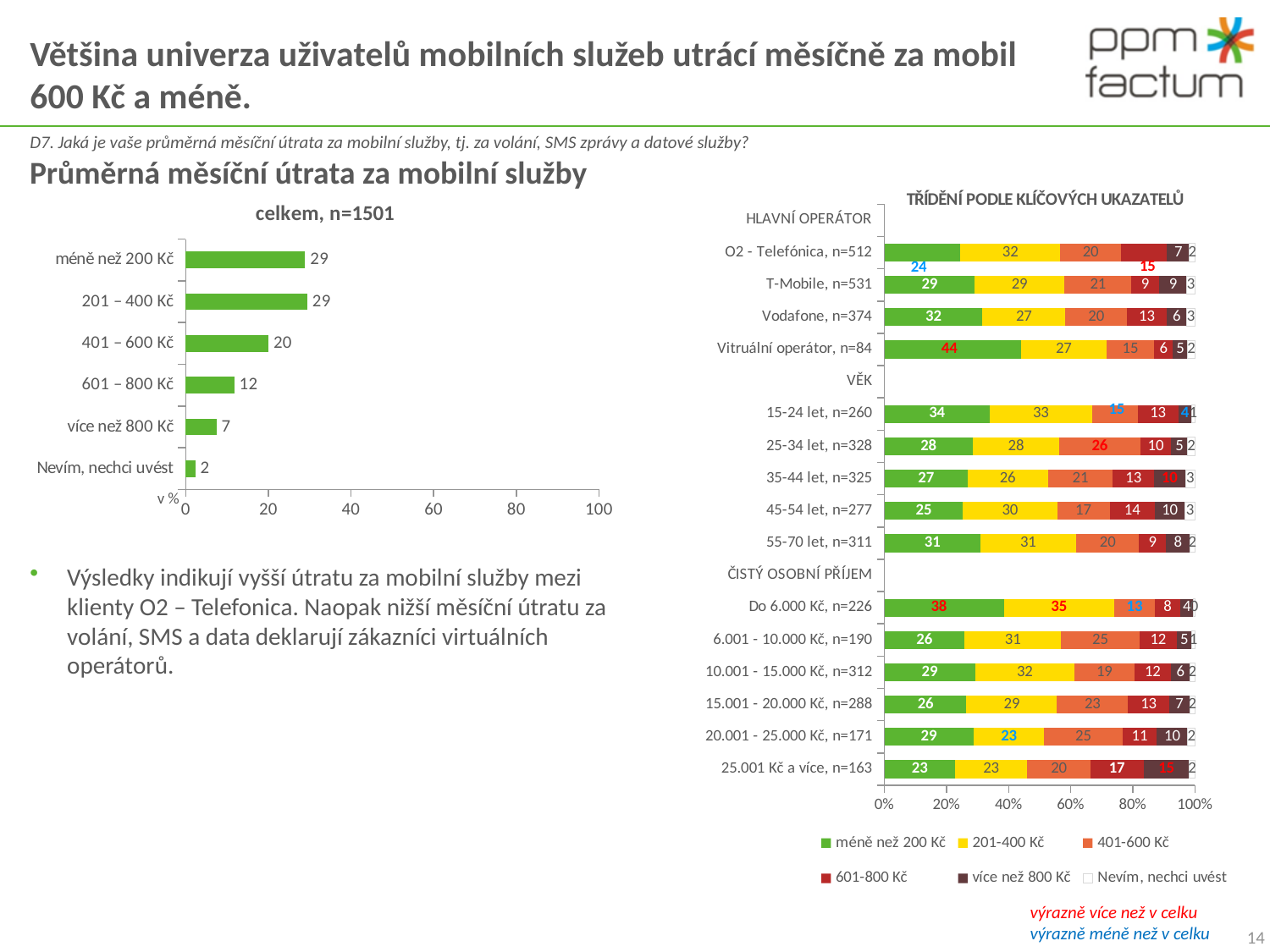
In the left chart 'celkem, n=1501', what is the value for '401 – 600 Kč'? 20 In the right chart 'TŘÍDĚNÍ PODLE KLÍČOVÝCH UKAZATELŮ', what is the difference between the '601-800 Kč' values for 'O2 - Telefónica, n=512' and 'T-Mobile, n=531'? 6 In the left chart 'celkem, n=1501', how many categories are shown? 6 What kind of chart is the left chart 'celkem, n=1501'? bar chart In the right chart 'TŘÍDĚNÍ PODLE KLÍČOVÝCH UKAZATELŮ', what is the 'méně než 200 Kč' value for 'Vitruální operátor, n=84'? 44 In the right chart 'TŘÍDĚNÍ PODLE KLÍČOVÝCH UKAZATELŮ', which is larger: the 'méně než 200 Kč' value for 'O2 - Telefónica, n=512' or for 'Vodafone, n=374'? Vodafone, n=374 In the right chart 'TŘÍDĚNÍ PODLE KLÍČOVÝCH UKAZATELŮ', what is the 'více než 800 Kč' value for '25.001 Kč a více, n=163'? 15 In the right chart 'TŘÍDĚNÍ PODLE KLÍČOVÝCH UKAZATELŮ', what is the '201-400 Kč' value for 'Do 6.000 Kč, n=226'? 35 How many series does the legend of the right chart 'TŘÍDĚNÍ PODLE KLÍČOVÝCH UKAZATELŮ' list? 6 In the left chart 'celkem, n=1501', which category has the lowest value? Nevím, nechci uvést In the left chart 'celkem, n=1501', what is the value for 'více než 800 Kč'? 7 In the left chart 'celkem, n=1501', what is the difference between '401 – 600 Kč' and '601 – 800 Kč'? 8